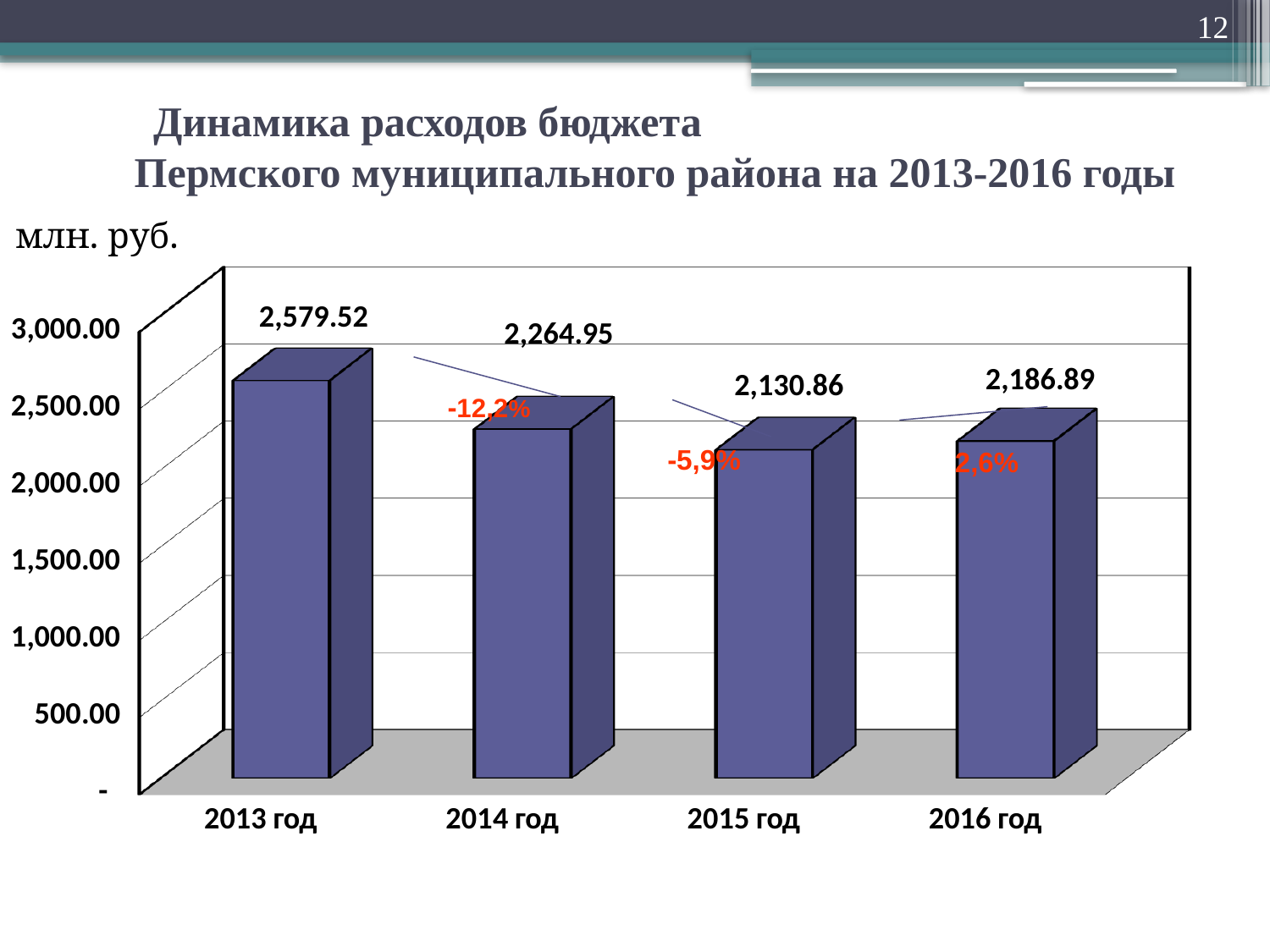
What is the value shown for 2015 год? 2,130.86 Which is larger, the value for 2014 год or the value for 2016 год? 2014 год What is the value shown for 2016 год? 2,186.89 What is the value shown for 2014 год? 2,264.95 Which year has the lowest budget expenditure? 2015 год What is the difference between the values for 2016 год and 2015 год? 56.03 What kind of chart is shown on the slide? bar chart How many years (bars) are shown in the chart? 4 Do the values rise or fall from 2013 год to 2015 год? fall What is the budget expenditure value shown for 2013 год? 2,579.52 Which year has the highest budget expenditure? 2013 год What is the difference between the values for 2013 год and 2014 год? 314.57